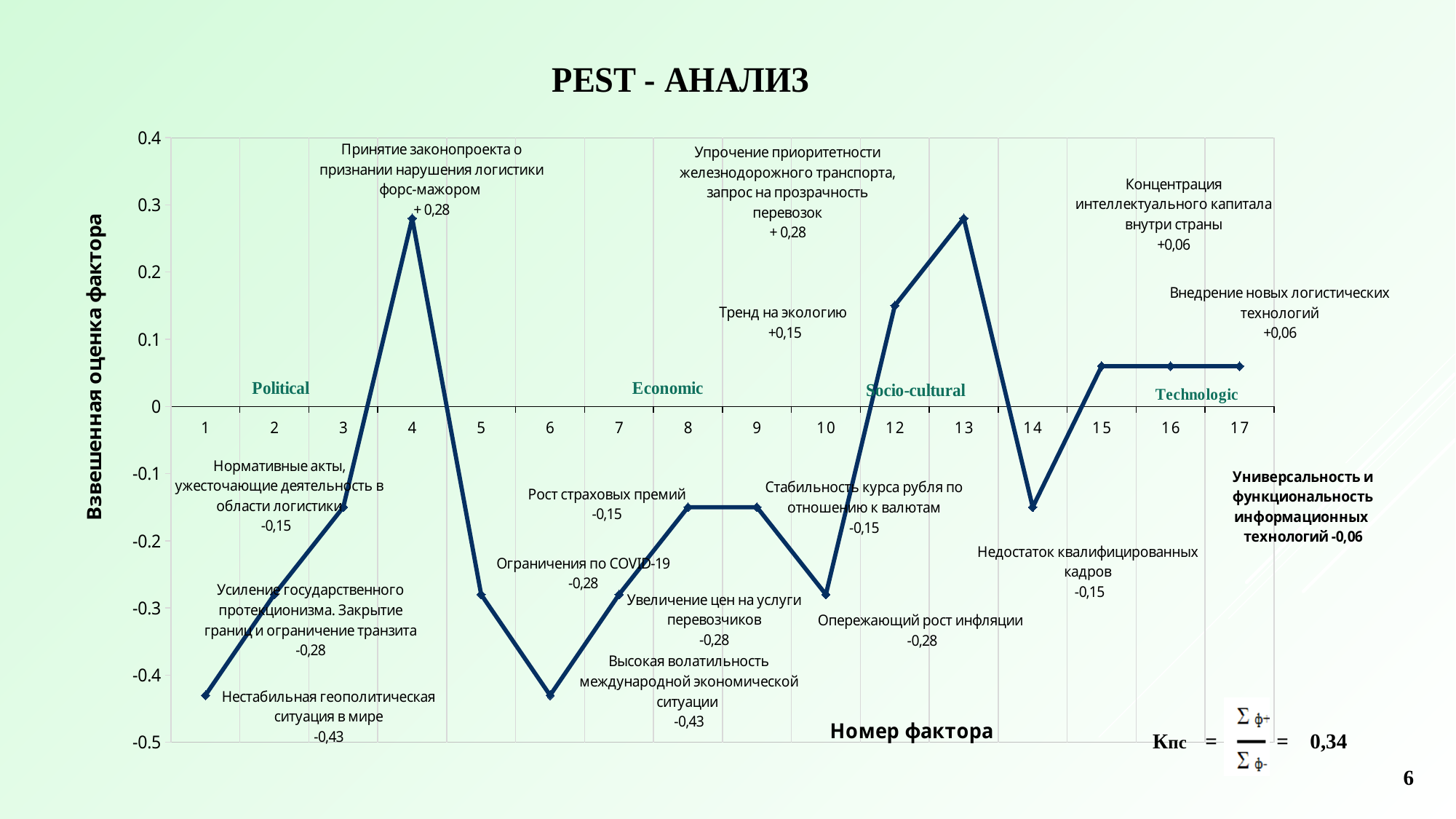
How many factor numbers are labelled along the x axis of the chart? 16 What is the title of the chart on the slide? PEST - АНАЛИЗ What weighted score is given for the factor 'Тренд на экологию'? +0,15 What weighted score is given for the factor 'Нестабильная геополитическая ситуация в мире'? -0,43 What is the difference between the value for factor 4 (+0,28) and the value for factor 5 (-0,28)? 0,56 What weighted score is given for the factor 'Ограничения по COVID-19'? -0,28 What is the label of the vertical axis of the chart? Взвешенная оценка фактора Which has the larger value, factor 12 or factor 14? factor 12 What kind of chart is shown on the slide? line chart Is the value for factor 14 greater or less than -0.1? less Is the value for factor 4 greater or less than 0.2? greater Does the line rise or fall from factor 13 to factor 14? fall